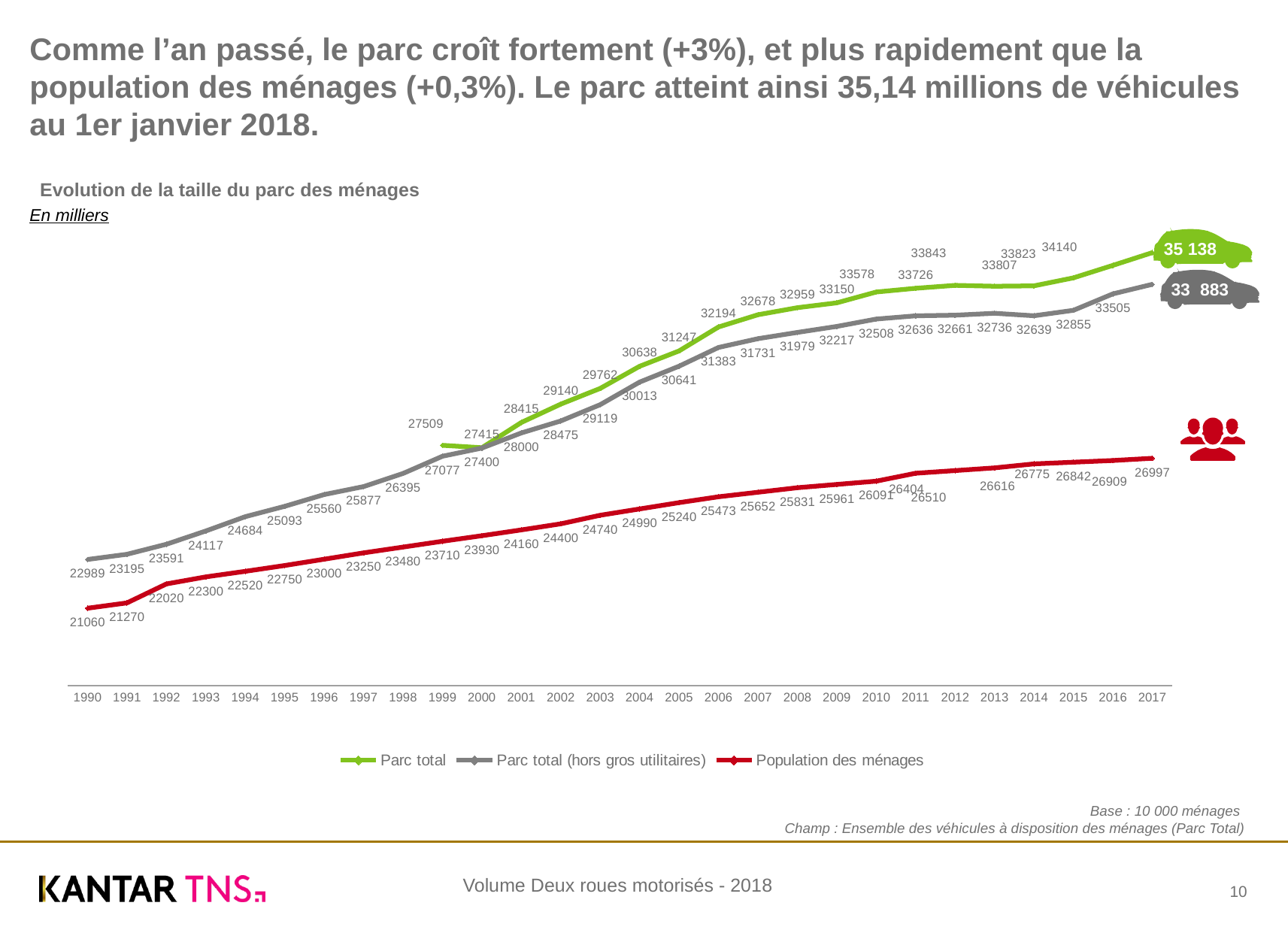
How many years are shown on the x axis? 28 Does the Population des ménages series rise or fall from 1990 to 2017? rise What is the value of Parc total in 2005? 31247 What is the difference between Population des ménages in 2017 and in 1990? 5937 What kind of chart is shown on the slide? line chart In which year is Parc total (hors gros utilitaires) at its lowest? 1990 What is the value of Parc total in 2017? 35 138 What is the value of Population des ménages in 1990? 21060 How many series does the legend list? 3 What is the value of Parc total (hors gros utilitaires) in 2017? 33 883 What colour is the Population des ménages line? red In 2010, which is larger: Parc total or Parc total (hors gros utilitaires)? Parc total